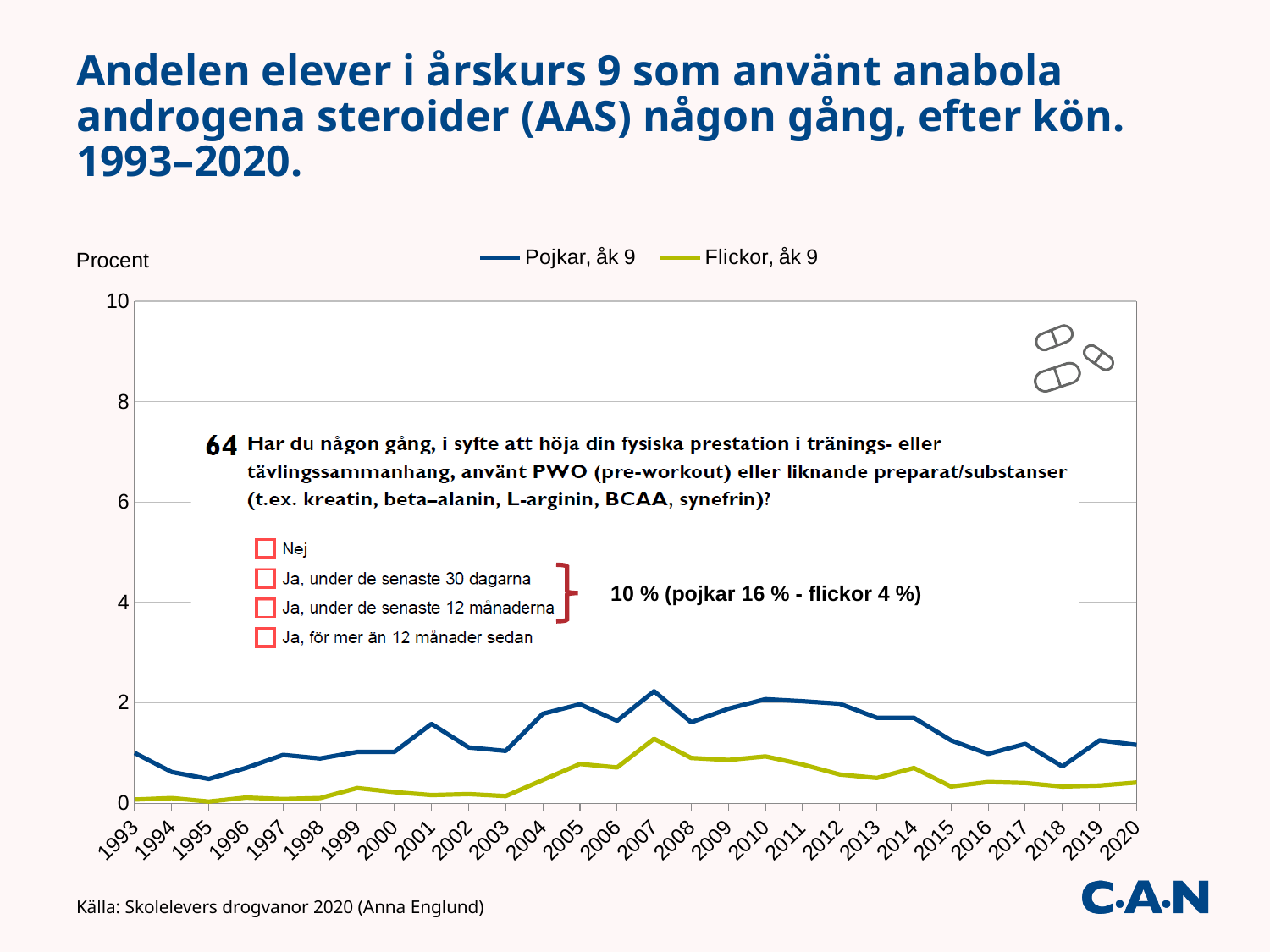
Is the value for Flickor, åk 9 in 2007 greater or less than 2? less Does the Pojkar, åk 9 line rise or fall between 2014 and 2016? fall How many series does the chart legend list? 2 Is the value for Pojkar, åk 9 in 2007 greater or less than 4? less Which series is higher in 2010, Pojkar, åk 9 or Flickor, åk 9? Pojkar, åk 9 In which year does the Flickor, åk 9 line reach its highest value? 2007 Is the value for Pojkar, åk 9 in 1995 greater or less than 2? less What kind of chart is shown on the slide? line chart How many years are plotted along the x axis of the chart? 28 Does the Flickor, åk 9 line rise or fall between 2003 and 2007? rise What label is shown on the vertical axis of the chart? Procent Which series is higher in 2001, Pojkar, åk 9 or Flickor, åk 9? Pojkar, åk 9